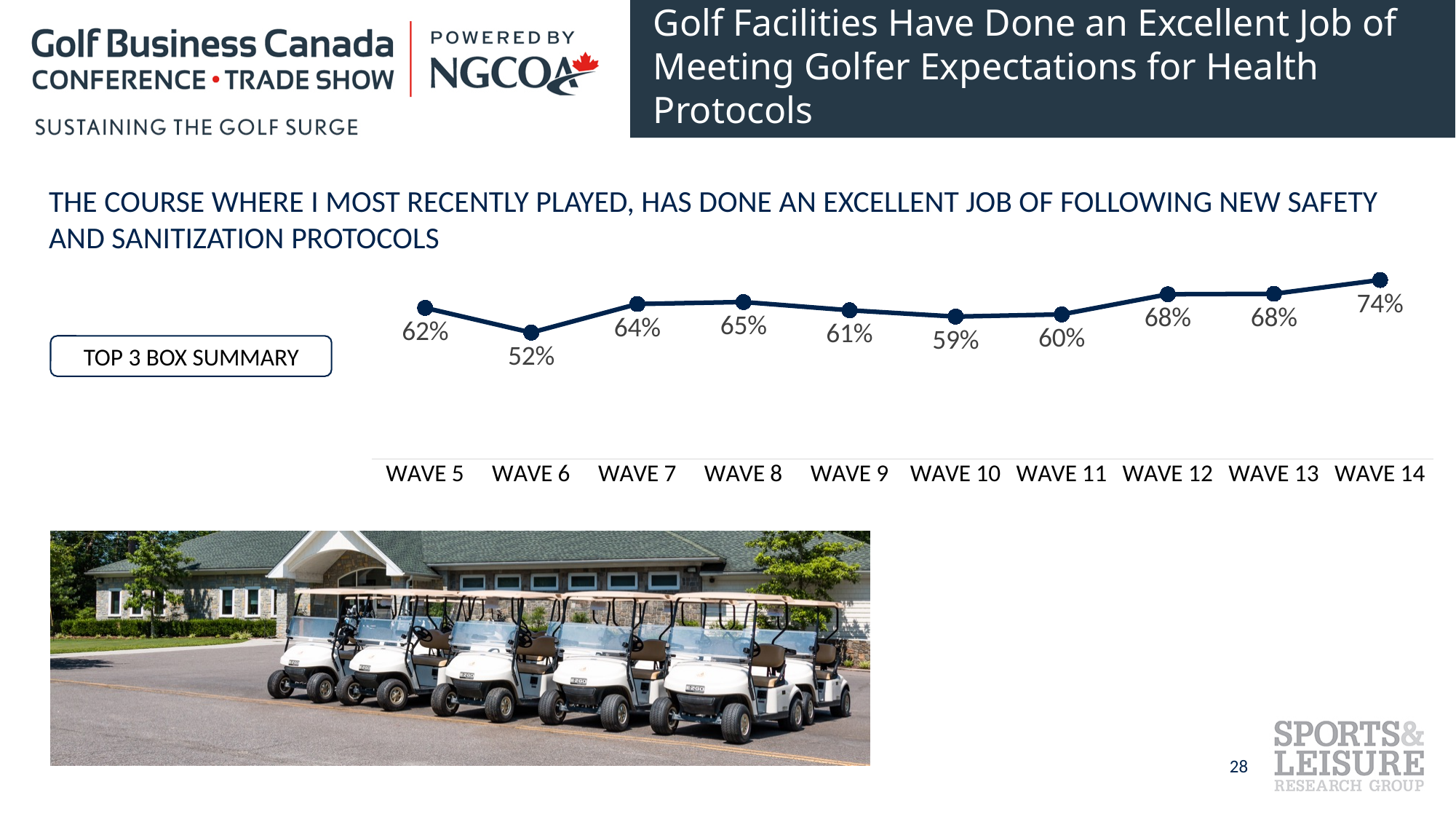
Do the values rise or fall from Wave 11 to Wave 14? Rise What is the value for Wave 5? 62% What is the value for Wave 14? 74% What is the value for Wave 10? 59% Which wave has the highest value? Wave 14 How many waves are plotted on the chart? 10 What is the value for Wave 6? 52% Which wave has the lowest value? Wave 6 What is the difference between the values for Wave 14 and Wave 6? 22% Which is larger, the value for Wave 7 or the value for Wave 11? Wave 7 What kind of chart is shown on the slide? Line chart What is the difference between the values for Wave 8 and Wave 9? 4%